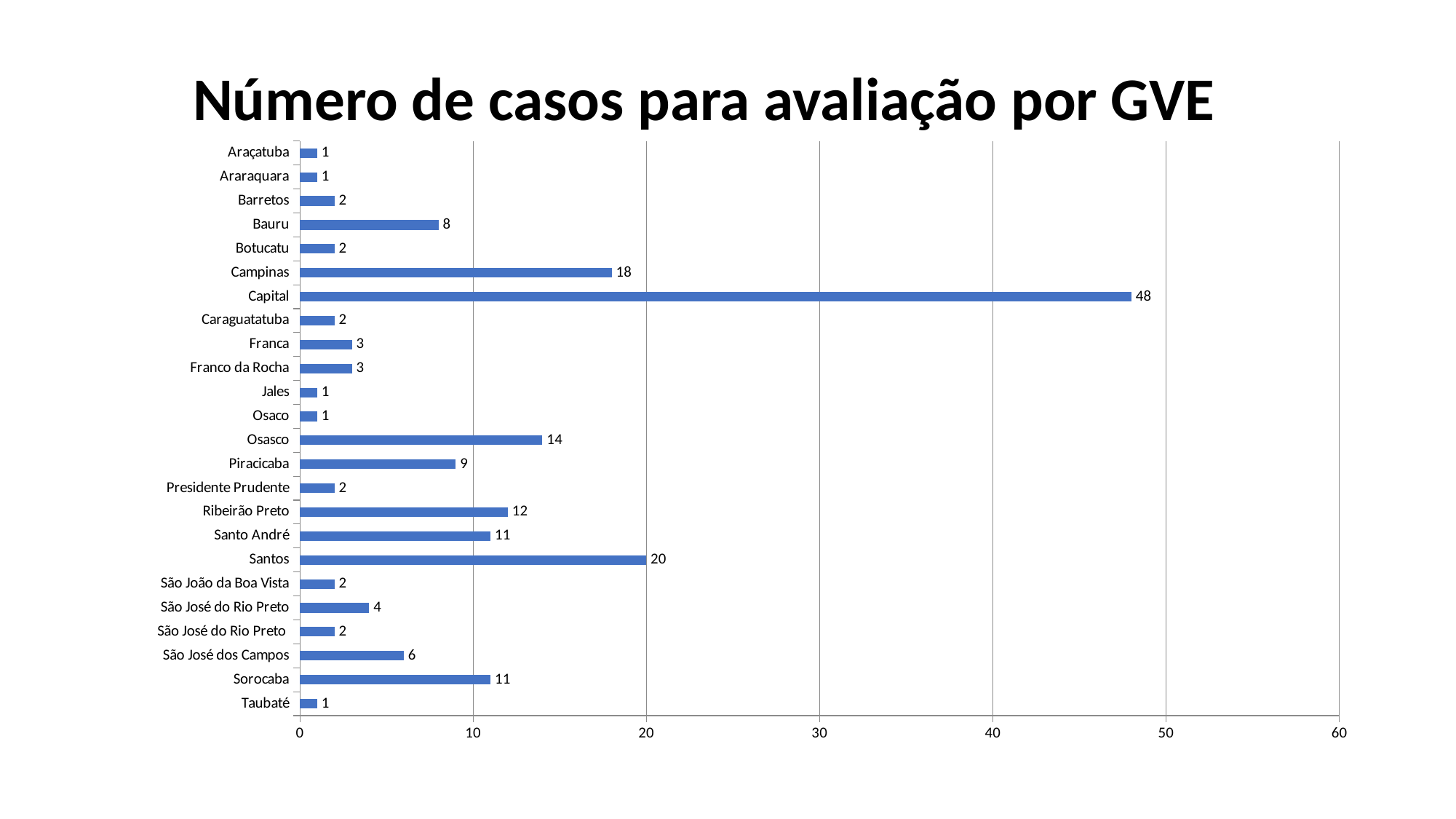
What is the number of cases for Campinas? 18 What is the value shown for Santos? 20 Which has a larger value, Sorocaba or Santo André? They are equal (11) Which has a larger value, Bauru or São José dos Campos? Bauru What is the value shown for Piracicaba? 9 What is the difference between the values for Capital and Santos? 28 Is the value for Capital greater or less than 40? greater What is the difference between the values for Osasco and Ribeirão Preto? 2 What type of chart is shown on the slide? Bar chart How many GVE categories are shown on the chart? 24 Which GVE has the highest number of cases? Capital What is the number of cases for Capital? 48